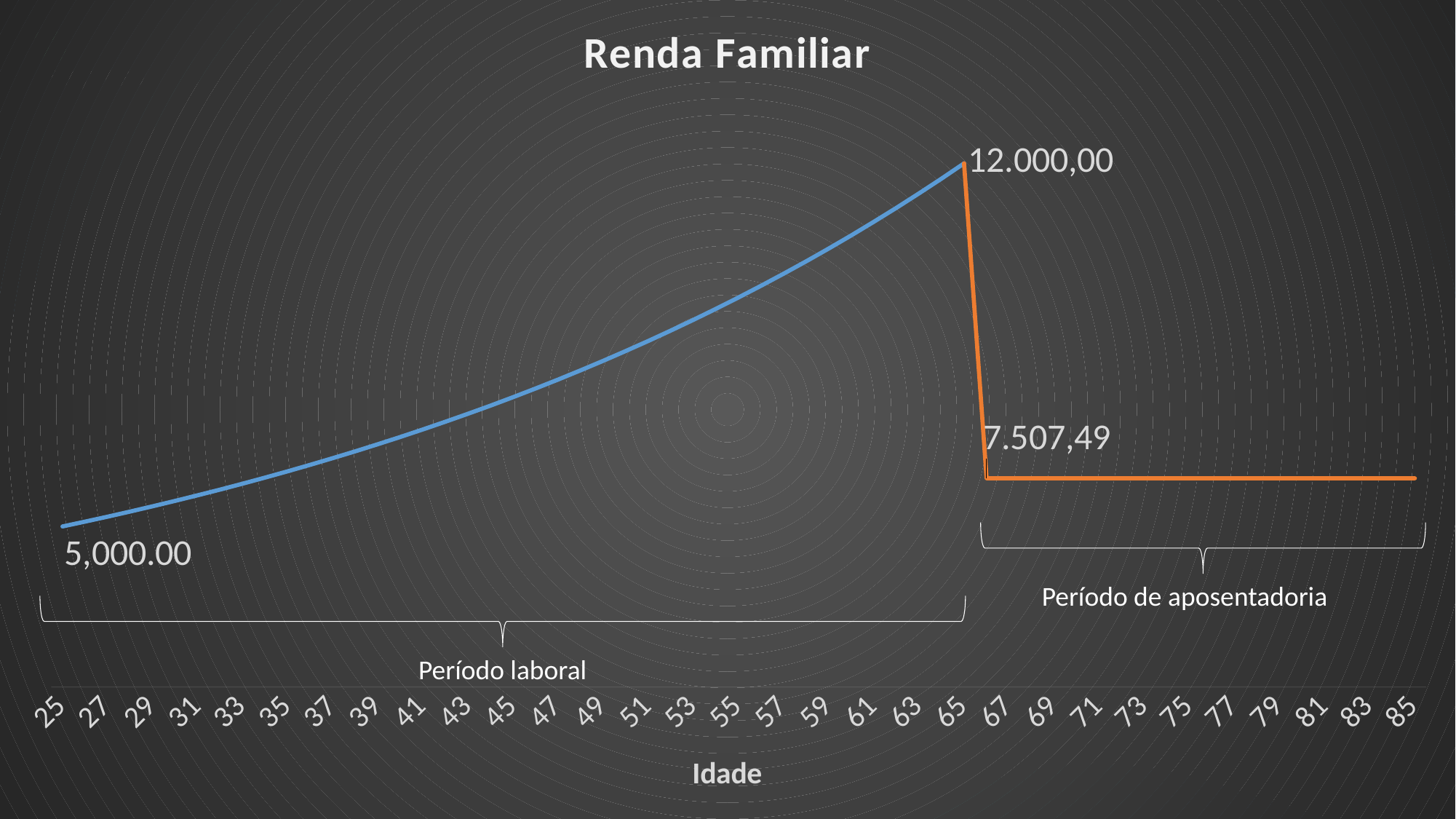
At what age does the Renda Familiar reach its highest value? 65 What is the value of Renda Familiar at age 25? 5,000.00 What is the title of the chart? Renda Familiar What is the difference between the value at age 65 (12.000,00) and the retirement value (7.507,49)? 4.492,51 Does the Renda Familiar rise or fall between age 25 and age 65? rise What is the title of the x axis? Idade What is the lowest labelled value on the chart? 5,000.00 Which is larger: the value at age 65 or the value during the Período de aposentadoria? the value at age 65 What kind of chart is shown on the slide? line chart How many age ticks are shown on the x axis? 31 What is the value of Renda Familiar during the Período de aposentadoria? 7.507,49 What is the value of Renda Familiar at age 65, the end of the Período laboral? 12.000,00